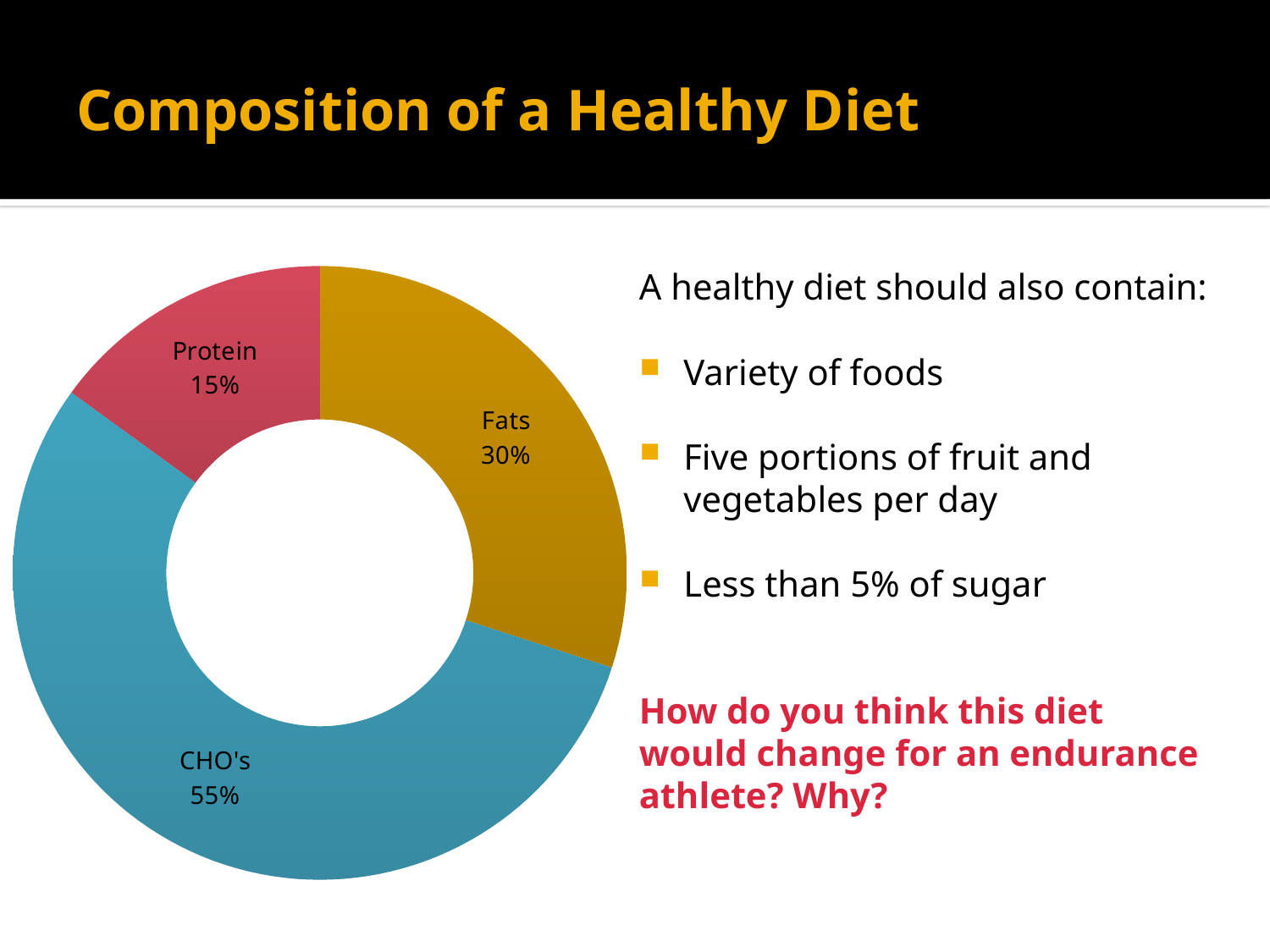
What percentage of the diet is made up of CHO's? 55% What colour is the Fats segment of the chart? Gold What is the difference in percentage points between Fats and Protein? 15 What percentage of the diet is made up of Protein? 15% Which component makes up the largest share of the diet? CHO's How many components are shown in the chart? 3 What colour is the CHO's segment of the chart? Blue Which component makes up the smallest share of the diet? Protein What kind of chart is shown on the slide? Doughnut (pie) chart Which is larger, the share for Fats or the share for Protein? Fats What is the difference in percentage points between CHO's and Fats? 25 What percentage of the diet is made up of Fats? 30%